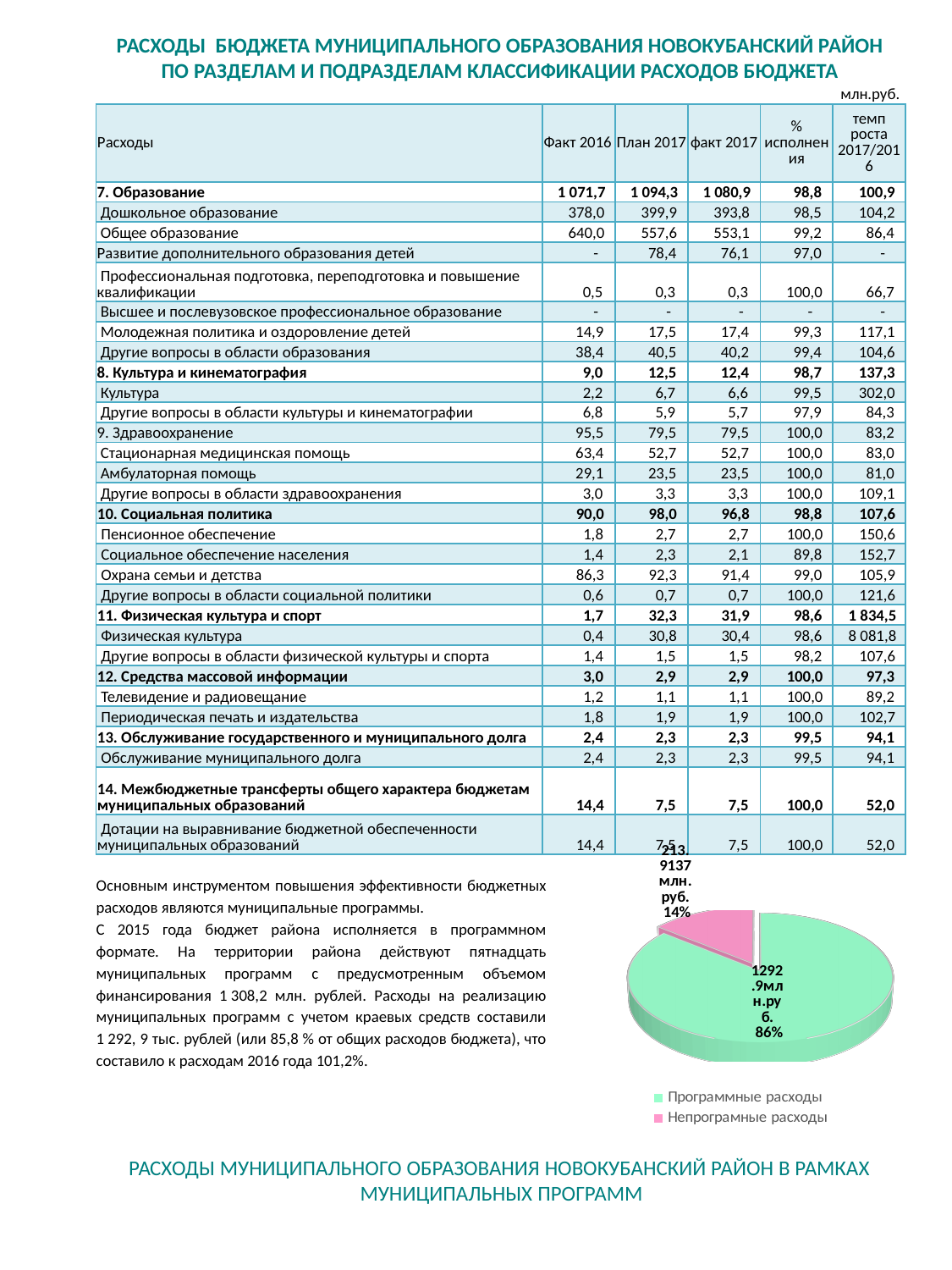
Which slice of the pie chart is the smallest? Непрограмные расходы What share of the pie does Непрограмные расходы take? 14% How many entries does the legend of the pie chart list? 2 Which slice of the pie chart is the largest? Программные расходы How many slices does the pie chart have? 2 What colour is the Непрограмные расходы slice in the pie chart? pink What kind of chart is shown on the slide? pie chart What value is labelled on the Программные расходы slice of the pie chart? 1292.9 млн.руб. Which is larger in the pie chart, Программные расходы or Непрограмные расходы? Программные расходы What colour is the Программные расходы slice in the pie chart? green By how many percentage points does the share of Программные расходы exceed the share of Непрограмные расходы? 72 What share of the pie does Программные расходы take? 86%